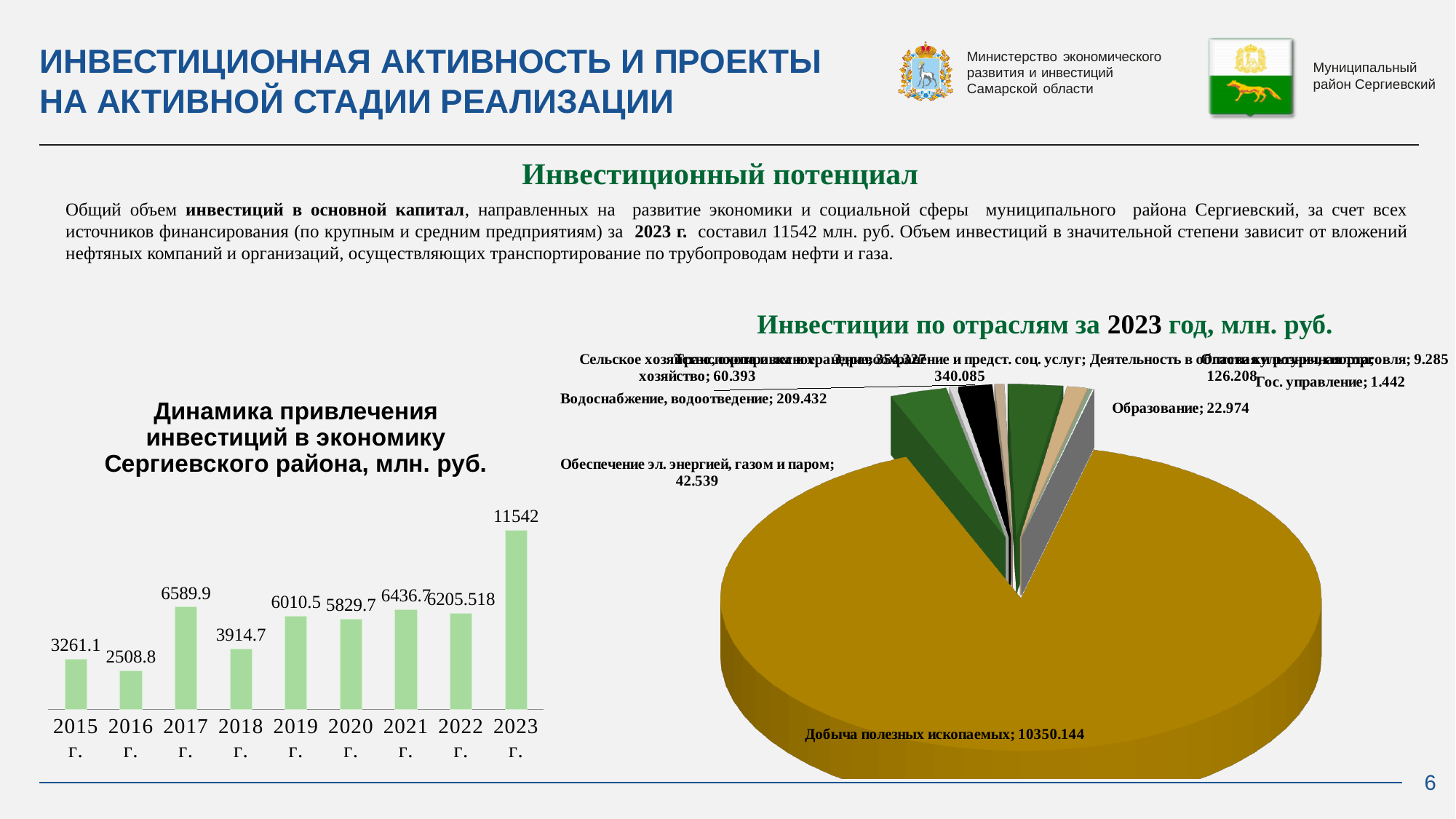
How many years are shown on the bar chart 'Динамика привлечения инвестиций в экономику Сергиевского района, млн. руб.'? 9 On the bar chart 'Динамика привлечения инвестиций в экономику Сергиевского района, млн. руб.', what is the value for 2017 г.? 6589.9 On the bar chart 'Динамика привлечения инвестиций в экономику Сергиевского района, млн. руб.', which year has the lowest value? 2016 г. What kind of chart is 'Динамика привлечения инвестиций в экономику Сергиевского района, млн. руб.'? Bar chart On the bar chart 'Динамика привлечения инвестиций в экономику Сергиевского района, млн. руб.', which is larger: the value for 2019 г. or 2020 г.? 2019 г. On the pie chart 'Инвестиции по отраслям за 2023 год, млн. руб.', what is the value for Добыча полезных ископаемых? 10350.144 On the bar chart 'Динамика привлечения инвестиций в экономику Сергиевского района, млн. руб.', what is the value for 2023 г.? 11542 On the bar chart 'Динамика привлечения инвестиций в экономику Сергиевского района, млн. руб.', which year has the highest value? 2023 г. On the pie chart 'Инвестиции по отраслям за 2023 год, млн. руб.', what is the value for Водоснабжение, водоотведение? 209.432 On the pie chart 'Инвестиции по отраслям за 2023 год, млн. руб.', what is the value for Образование? 22.974 What kind of chart is 'Инвестиции по отраслям за 2023 год, млн. руб.'? Pie chart On the bar chart 'Динамика привлечения инвестиций в экономику Сергиевского района, млн. руб.', what is the difference between the values for 2023 г. and 2022 г.? 5336.482